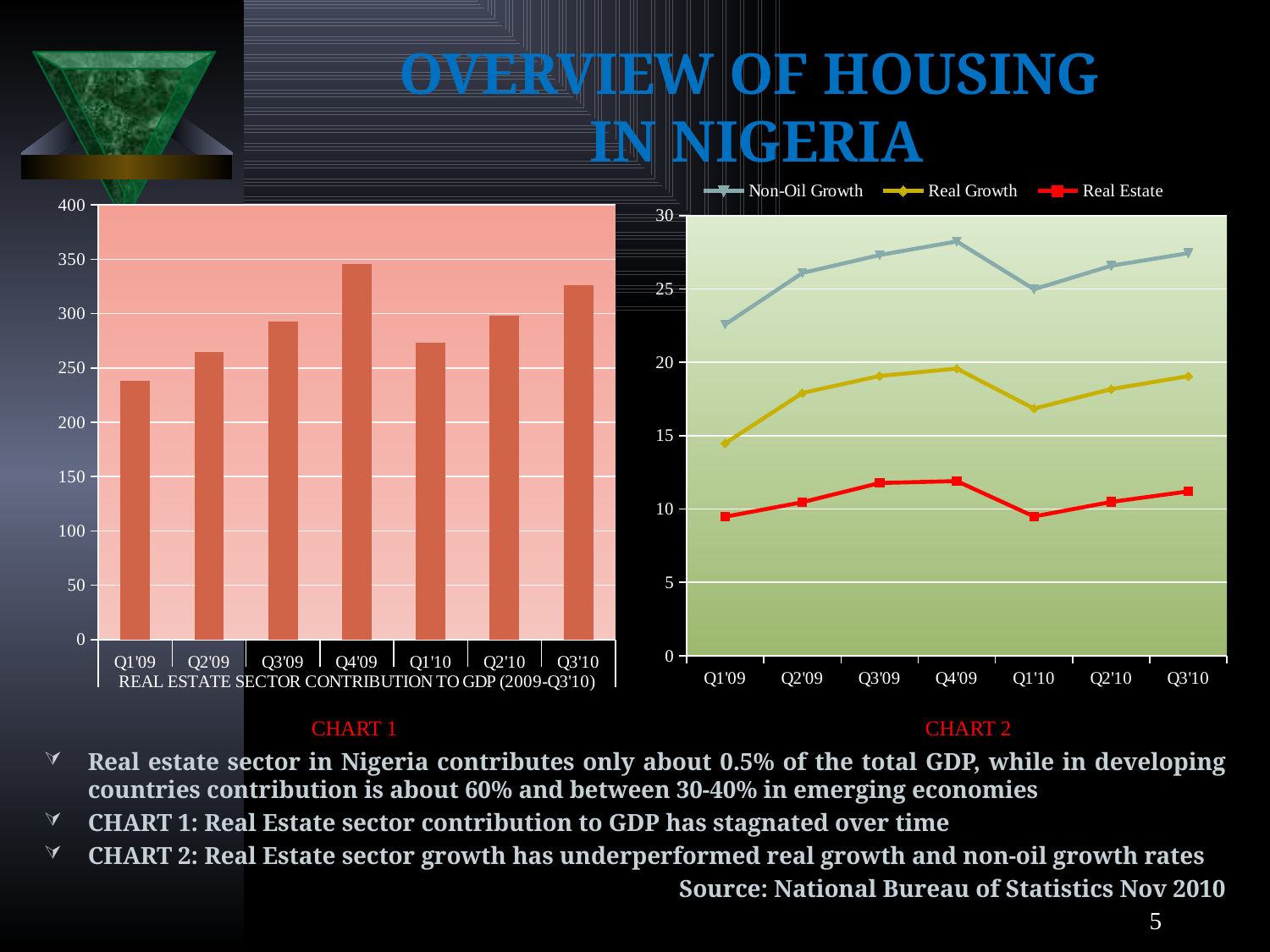
What kind of chart is Chart 2, on the right of the slide? line chart What is the title printed below the bars in Chart 1? REAL ESTATE SECTOR CONTRIBUTION TO GDP (2009-Q3'10) In Chart 2, which series has the lowest values across all quarters? Real Estate In Chart 1, how many quarters are shown on the x axis? 7 How many series does the legend of Chart 2 list? 3 In Chart 1, which quarter has the highest real estate sector contribution to GDP? Q4'09 In Chart 1, which quarter has the lowest real estate sector contribution to GDP? Q1'09 What kind of chart is Chart 1, on the left of the slide? bar chart In Chart 1, is the value for Q4'09 greater or less than 300? greater In Chart 1, which is larger, the value for Q3'10 or the value for Q1'10? Q3'10 In Chart 1, is the value for Q1'09 greater or less than 250? less In Chart 2, is the Non-Oil Growth value for Q1'09 greater or less than 25? less